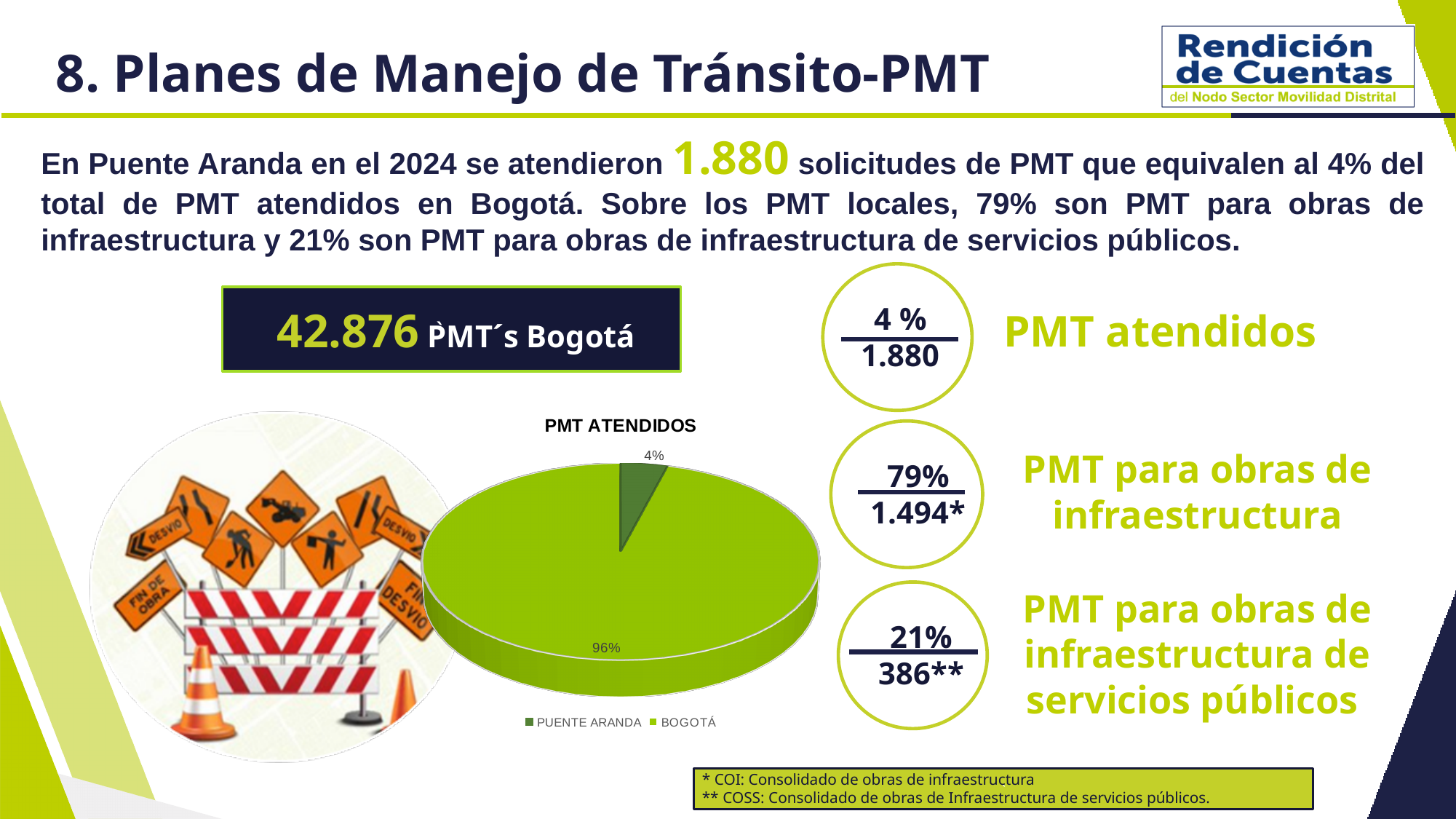
In the 'PMT ATENDIDOS' pie chart, which category has the smallest slice? PUENTE ARANDA In the 'PMT ATENDIDOS' pie chart, which category has the largest slice? BOGOTÁ In the 'PMT ATENDIDOS' pie chart, what percentage is shown for PUENTE ARANDA? 4% In the 'PMT ATENDIDOS' pie chart, what colour is the PUENTE ARANDA slice? dark green In the 'PMT ATENDIDOS' pie chart, what percentage is shown for BOGOTÁ? 96% In the 'PMT ATENDIDOS' pie chart, what is the difference in percentage points between the BOGOTÁ slice and the PUENTE ARANDA slice? 92 What kind of chart is shown under the title 'PMT ATENDIDOS'? pie chart In the 'PMT ATENDIDOS' pie chart, which slice is larger: PUENTE ARANDA or BOGOTÁ? BOGOTÁ What is the title of the pie chart on the slide? PMT ATENDIDOS In the 'PMT ATENDIDOS' pie chart, how many categories does the legend list? 2